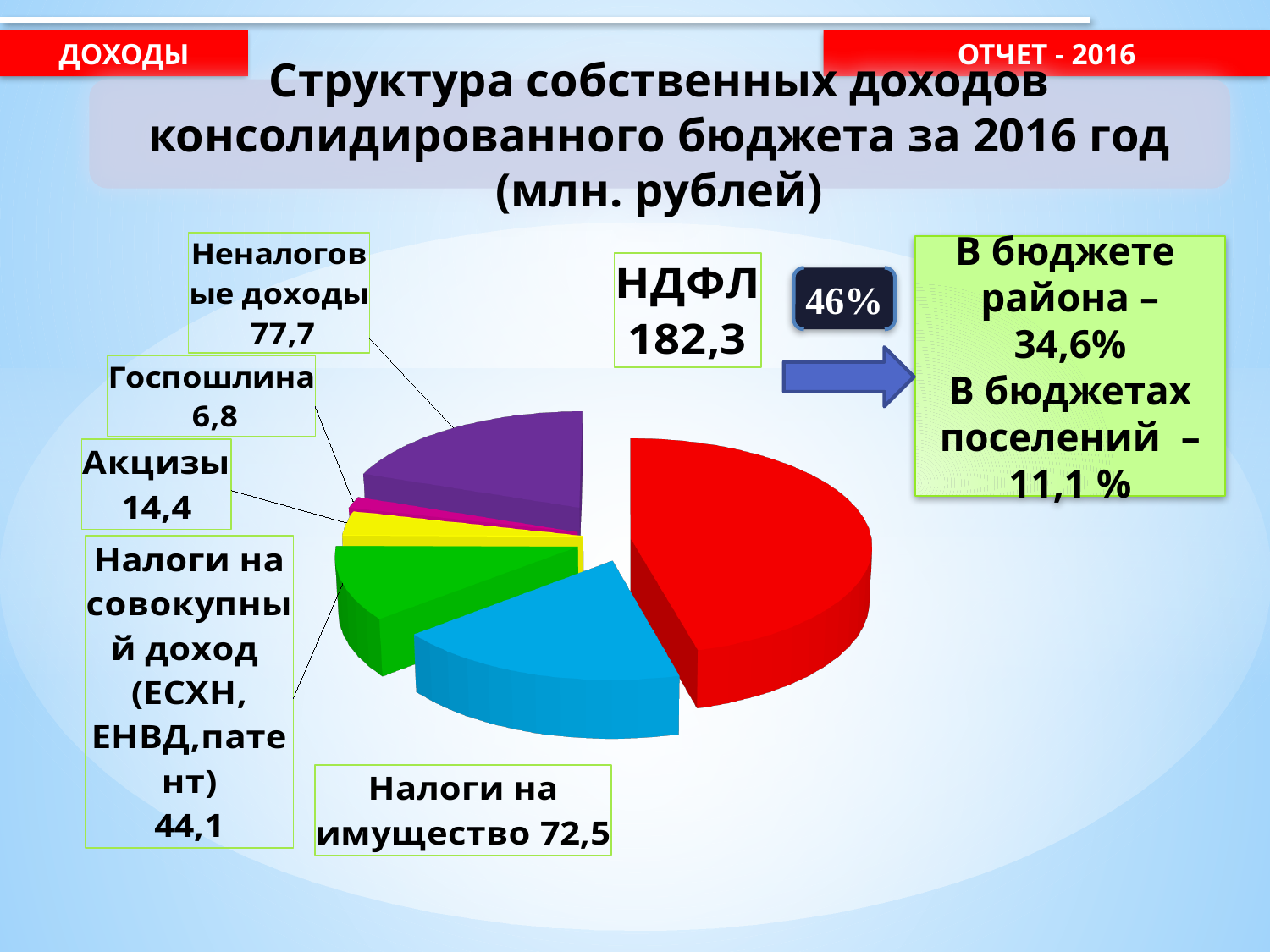
What is the value for Неналоговые доходы? 77,7 What is the value for Налоги на имущество? 72,5 What share of the pie does НДФЛ account for, as shown on the slide? 46% Which category has the largest value in the pie chart? НДФЛ Which is larger: Неналоговые доходы or Налоги на имущество? Неналоговые доходы What is the difference between the values for НДФЛ and Налоги на имущество? 109,8 Which category has the smallest value in the pie chart? Госпошлина What is the difference between the values for Акцизы and Госпошлина? 7,6 How many slices does the pie chart have? 6 What is the value for НДФЛ? 182,3 What is the value for Госпошлина? 6,8 What type of chart is shown on the slide? pie chart